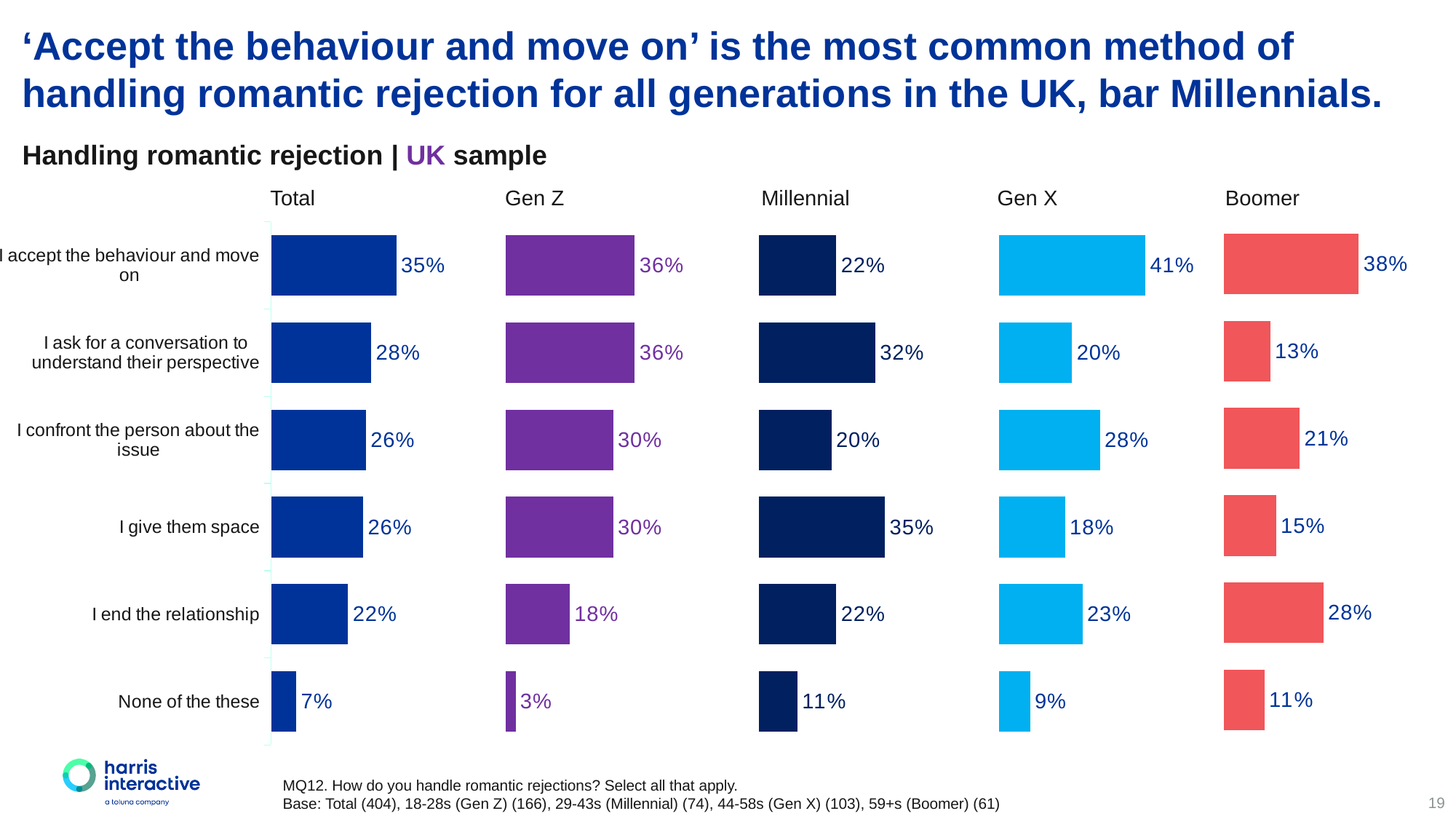
In the Gen Z chart, which category has the lowest value? None of the these In the Total chart, what percentage is shown for 'I accept the behaviour and move on'? 35% In the Millennial chart, what percentage is shown for 'I give them space'? 35% Which is larger in the Gen Z chart: 'I confront the person about the issue' or 'I end the relationship'? I confront the person about the issue In the Millennial chart, which category has the highest value? I give them space In the Boomer chart, what percentage is shown for 'I end the relationship'? 28% In the Gen X chart, what is the difference between 'I confront the person about the issue' and 'I give them space'? 10% In the Gen X chart, which category has the highest value? I accept the behaviour and move on How many generation charts (excluding Total) are shown on the slide? 4 What type of chart is used for the Gen Z data? Bar chart How many categories are shown in the Total chart? 6 In the Boomer chart, what is the difference between 'I accept the behaviour and move on' and 'I ask for a conversation to understand their perspective'? 25%